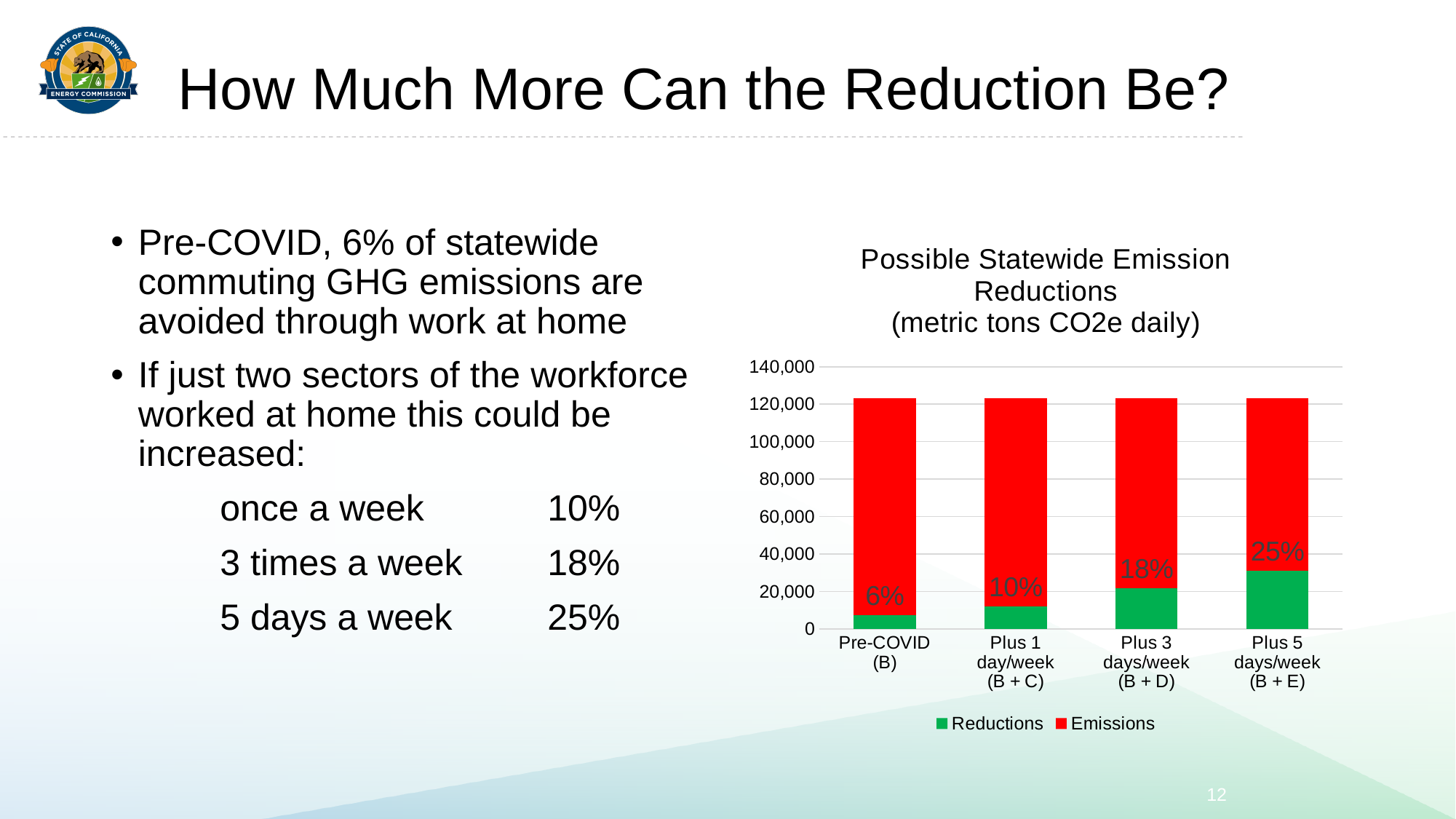
Which category has the largest Reductions segment? Plus 5 days/week (B + E) How many series does the chart legend list? 2 Do the Reductions values rise or fall from left to right along the x axis? rise Which colour represents Reductions in the chart legend? green What percentage label is shown on the Pre-COVID (B) bar? 6% Is the total height of the Pre-COVID (B) bar greater or less than 100,000? greater Which category has the smallest Reductions segment? Pre-COVID (B) How many categories are shown along the x axis of the chart? 4 Is the Reductions value for Plus 1 day/week (B + C) greater or less than 20,000? less What kind of chart is shown on the slide? bar chart What percentage label is shown on the Plus 5 days/week (B + E) bar? 25% What percentage label is shown on the Plus 3 days/week (B + D) bar? 18%